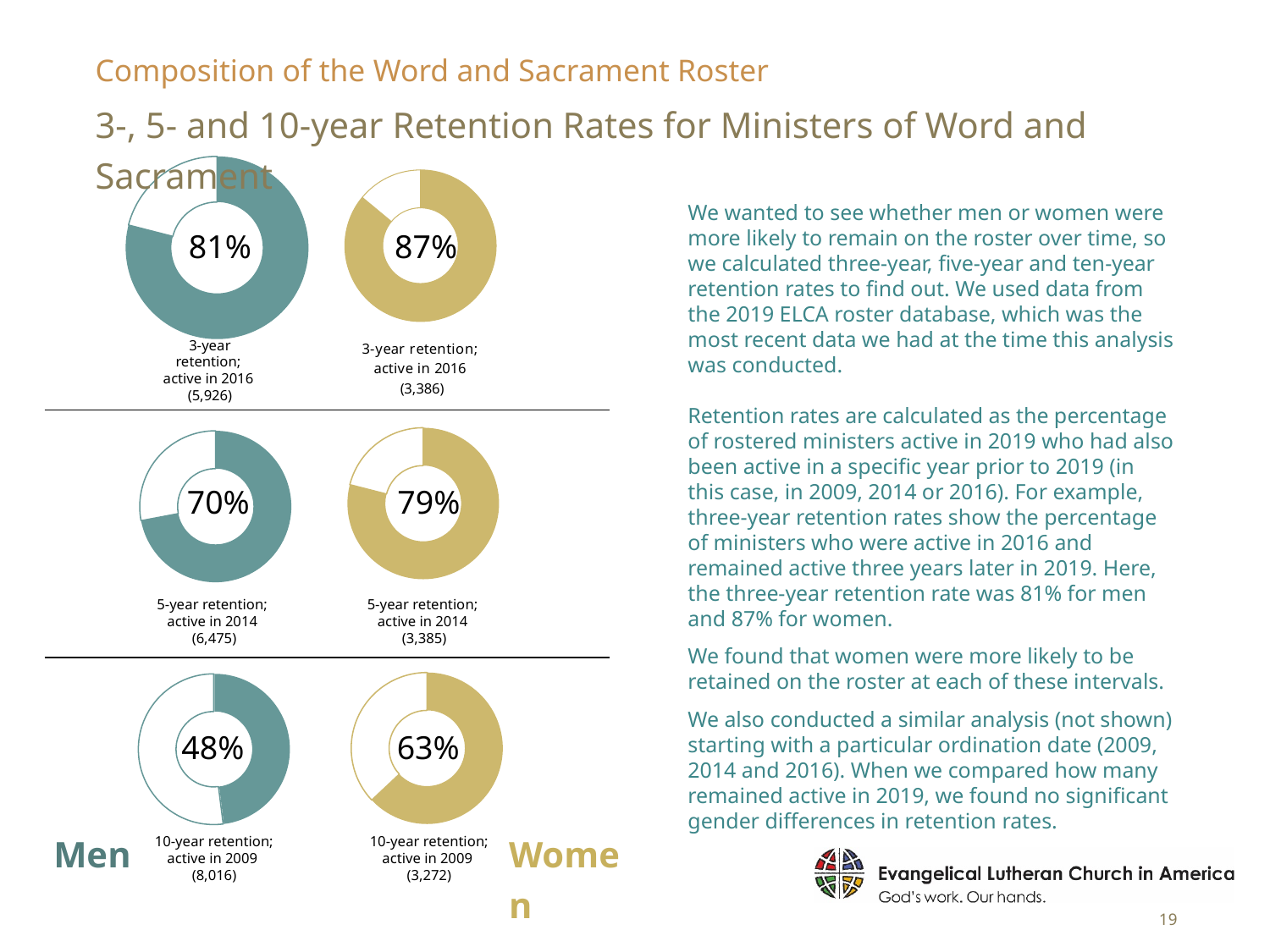
What kind of chart is used to show the retention rates on this slide? Donut (pie) chart Which of the six donut charts shows the lowest retention rate? 10-year retention for men (48%) Which of the six donut charts shows the highest retention rate? 3-year retention for women (87%) What is the 5-year retention rate shown in the donut chart for men (middle left)? 70% How many men were active in 2009, according to the label under the men's 10-year retention chart? 8,016 What is the 3-year retention rate shown in the donut chart for women (top right)? 87% What is the difference between the 5-year retention rates for women and men? 9 percentage points Is the 10-year retention rate higher for men or for women? Women What is the 10-year retention rate shown in the donut chart for women (bottom right)? 63% What is the 10-year retention rate shown in the donut chart for men (bottom left)? 48% How many donut charts are shown on the slide? 6 What is the 3-year retention rate shown in the donut chart for men (top left)? 81%